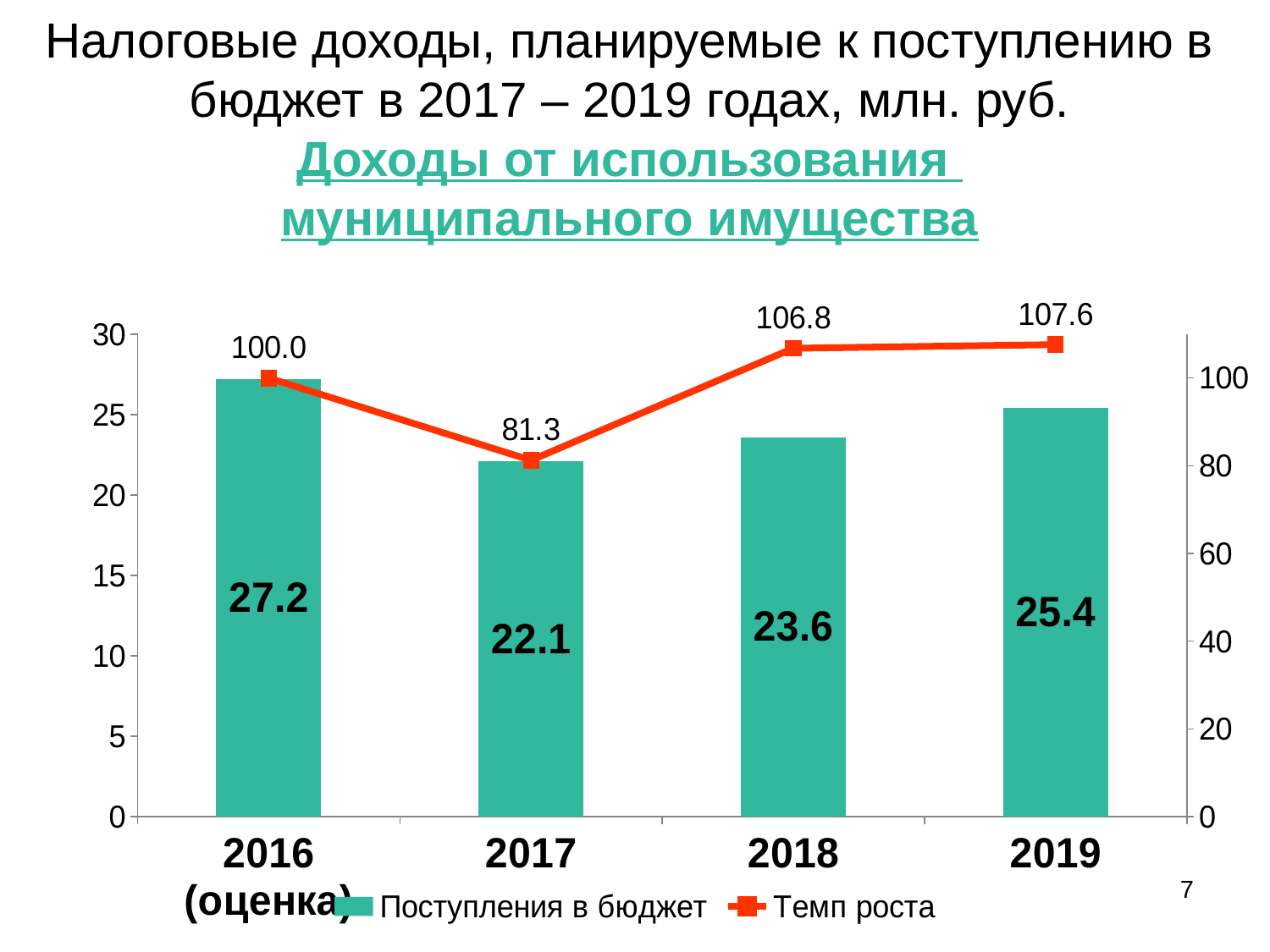
What colour is the Темп роста line? red Which year has the lowest value of Темп роста? 2017 How many series does the legend list? 2 What kind of chart is used for the Поступления в бюджет series? bar chart What is the difference between Поступления в бюджет in 2016 and 2017? 5.1 What is the value of Поступления в бюджет for 2019? 25.4 How many years are shown on the x axis? 4 Which is larger, Поступления в бюджет in 2018 or in 2019? 2019 What is the value of Темп роста for 2018? 106.8 Does Поступления в бюджет rise or fall from 2017 to 2019? rise What is the value of Поступления в бюджет for 2017? 22.1 Which year has the highest value of Поступления в бюджет? 2016 (оценка)